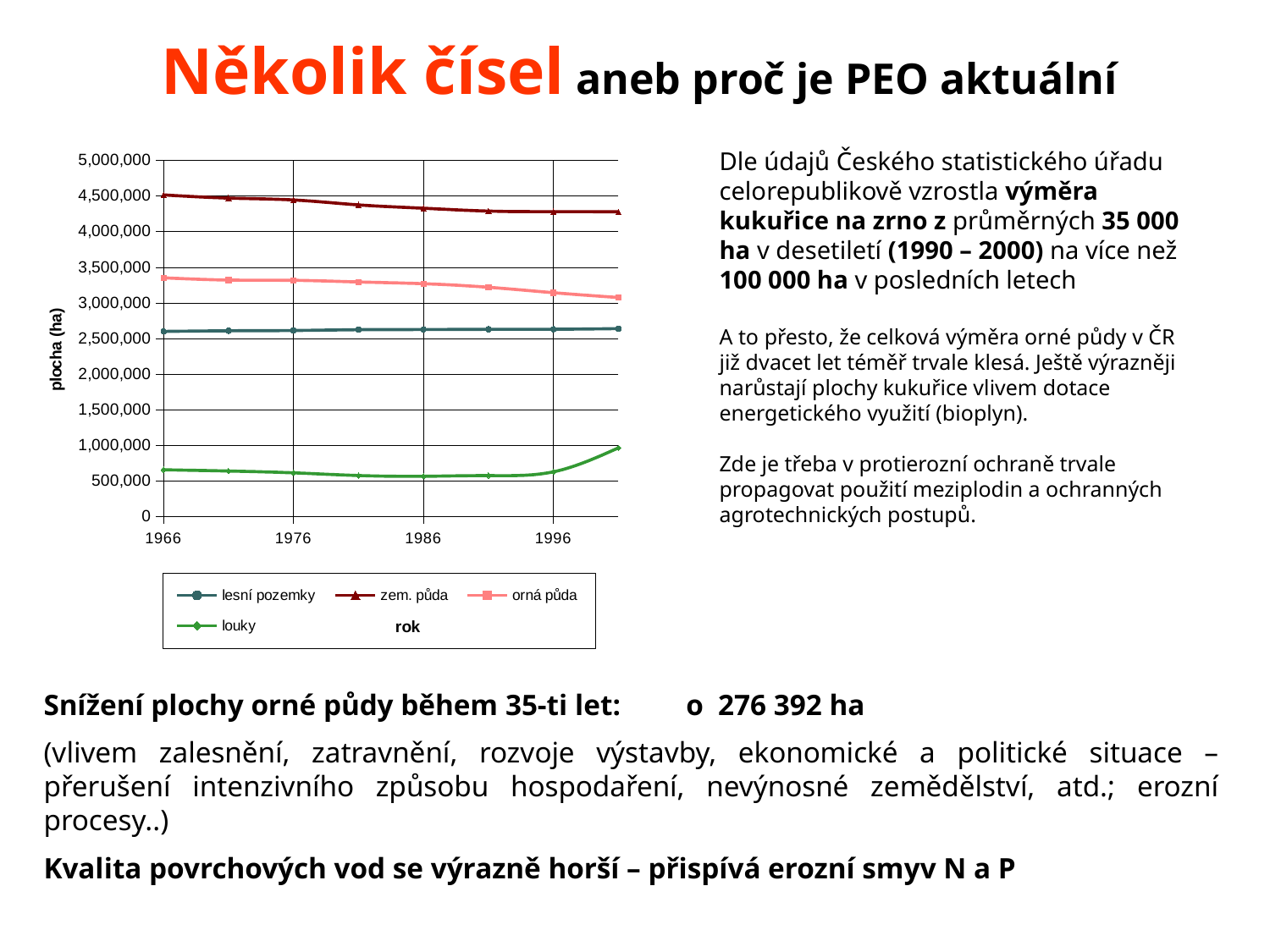
Which series has the highest values throughout the chart? zem. půda Is the value for zem. půda in 1966 greater or less than 4,000,000? greater Do the values for orná půda rise or fall from 1966 to the end of the chart? fall How many series does the chart legend list? 4 Is the value for orná půda in 1996 greater or less than 3,500,000? less Do the values for louky rise or fall after 1996? rise In 1976, which is larger: lesní pozemky or louky? lesní pozemky Which series has the lowest values throughout the chart? louky What kind of chart is shown on the slide? line chart What is the title of the vertical axis? plocha (ha) Is the value for louky in 1966 greater or less than 1,000,000? less Do the values for zem. půda rise or fall from 1966 to the end of the chart? fall